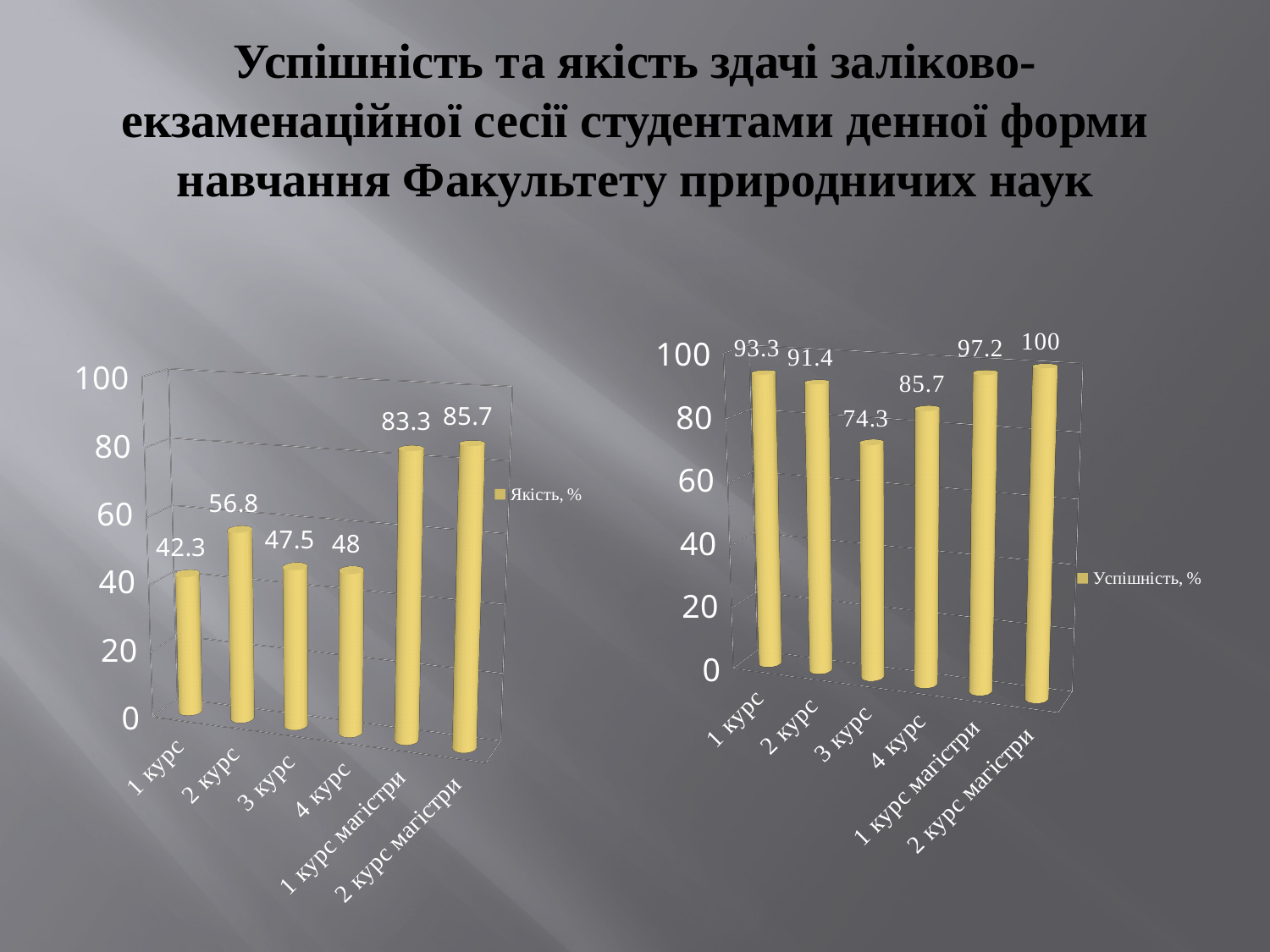
What type of chart is the right chart (Успішність, %)? bar chart In the right chart (Успішність, %), what is the value for 3 курс? 74.3 In the right chart (Успішність, %), which is larger: the value for 1 курс or the value for 4 курс? 1 курс In the left chart (Якість, %), what is the difference between the values for 1 курс магістри and 1 курс? 41 In the left chart (Якість, %), which category has the lowest value? 1 курс How many series does the legend of the left chart list? 1 In the right chart (Успішність, %), which category has the lowest value? 3 курс In the right chart (Успішність, %), which category has the highest value? 2 курс магістри In the left chart (Якість, %), which category has the highest value? 2 курс магістри How many categories are shown in the left chart (Якість, %)? 6 In the left chart (Якість, %), what is the value for 2 курс? 56.8 What is the legend entry of the right chart? Успішність, %